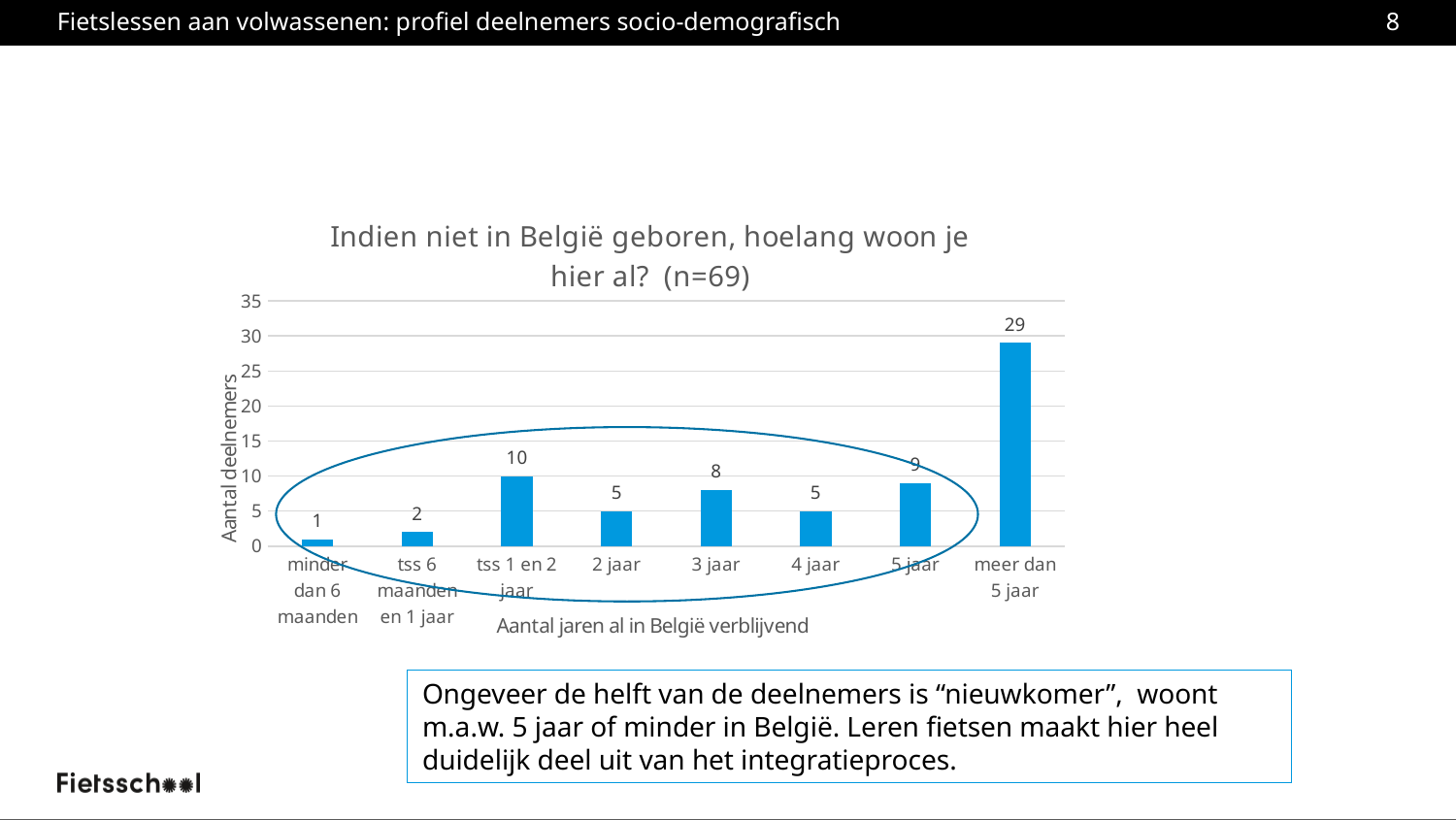
What is the sample size (n) given in the chart title? 69 Is the value for 'meer dan 5 jaar' greater or less than 25? greater Which category has the lowest value? minder dan 6 maanden Which is larger, the value for '5 jaar' or the value for '3 jaar'? 5 jaar How many categories are shown on the x axis? 8 What is the value for '3 jaar'? 8 What kind of chart is this? bar chart Which category has the highest value? meer dan 5 jaar What is the value for 'meer dan 5 jaar'? 29 What is the difference between the values for 'meer dan 5 jaar' and 'tss 1 en 2 jaar'? 19 What is the label of the y axis? Aantal deelnemers What is the value for 'tss 1 en 2 jaar'? 10